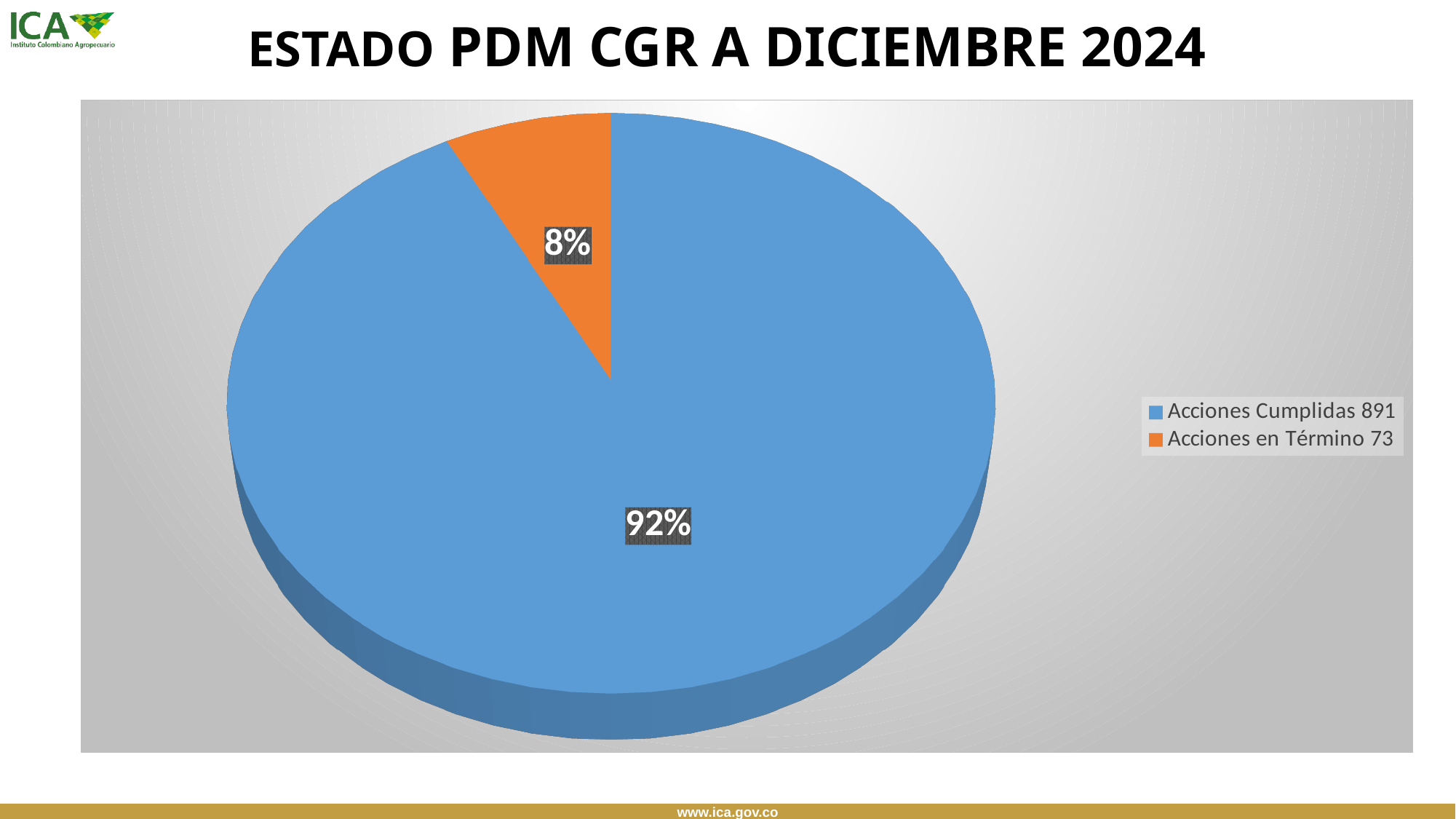
What number is shown next to Acciones Cumplidas in the legend? 891 What is the title of the chart on the slide? ESTADO PDM CGR A DICIEMBRE 2024 What colour is the Acciones en Término slice? orange Which is larger, the share for Acciones Cumplidas or for Acciones en Término? Acciones Cumplidas Which category has the largest slice of the pie? Acciones Cumplidas How many slices does the pie chart have? 2 What kind of chart is shown on the slide? pie chart Which category has the smallest slice of the pie? Acciones en Término What percentage share does the Acciones Cumplidas slice have? 92% What percentage share does the Acciones en Término slice have? 8% What number is shown next to Acciones en Término in the legend? 73 What is the difference in percentage points between the Acciones Cumplidas share and the Acciones en Término share? 84 percentage points